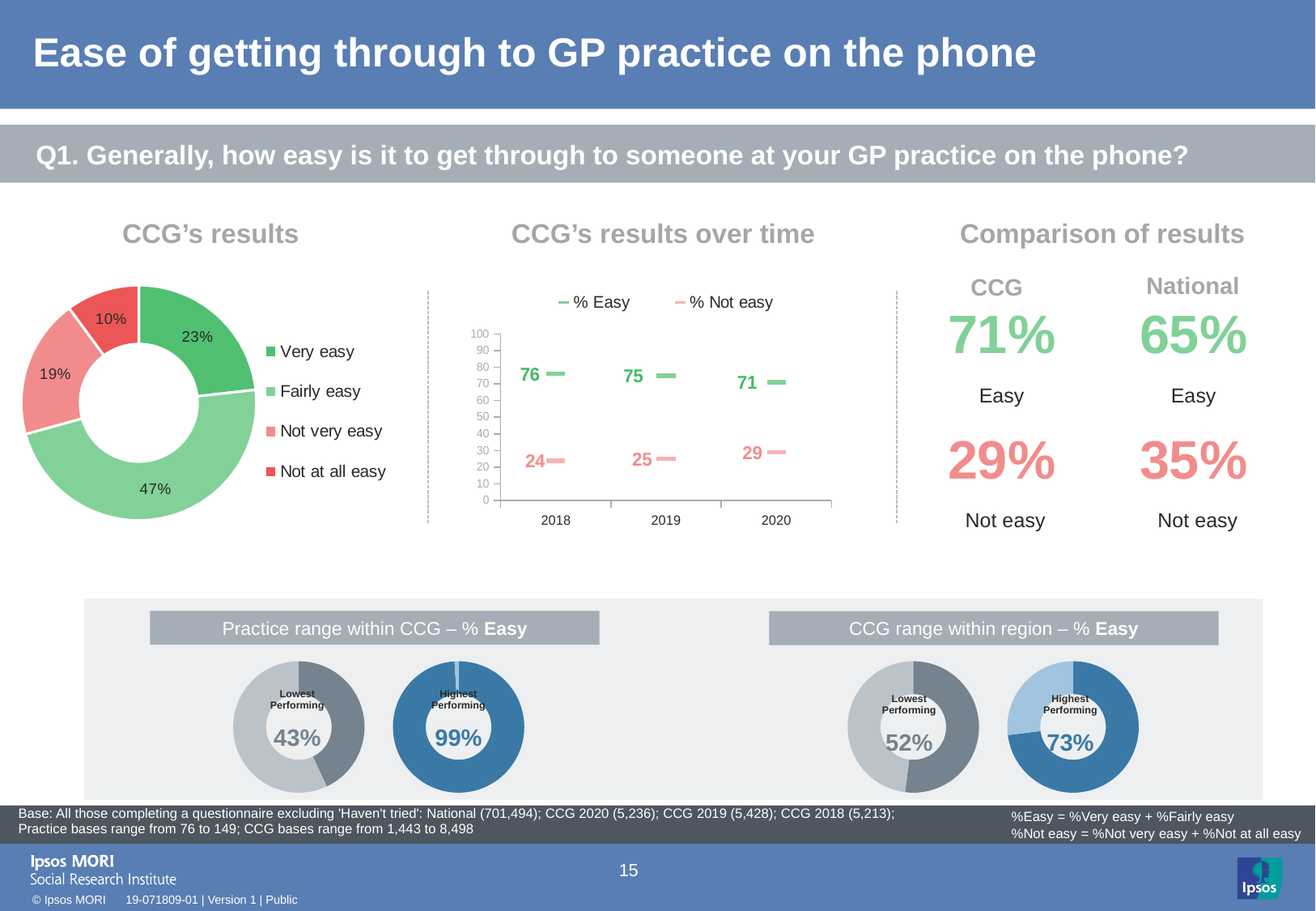
In the 'CCG's results' chart, which category has the largest share? Fairly easy In the 'CCG's results over time' chart, how many series does the legend list? 2 In the 'CCG's results' chart, what percentage is shown for 'Not at all easy'? 10% In the 'CCG's results over time' chart, what is the '% Not easy' value for 2020? 29 In the 'CCG's results' chart, how many categories does the legend list? 4 In the 'CCG's results' chart, what percentage is shown for 'Fairly easy'? 47% In the 'CCG's results' chart, what is the difference between the 'Very easy' and 'Not very easy' percentages? 4% In the 'CCG's results over time' chart, what is the '% Easy' value for 2018? 76 What kind of chart is the 'CCG's results' chart? Donut chart In the 'CCG's results' chart, which category has the smallest share? Not at all easy In the 'CCG's results over time' chart, does the '% Easy' series rise or fall from 2018 to 2020? Fall In the 'CCG's results over time' chart, what is the difference between '% Easy' and '% Not easy' in 2019? 50